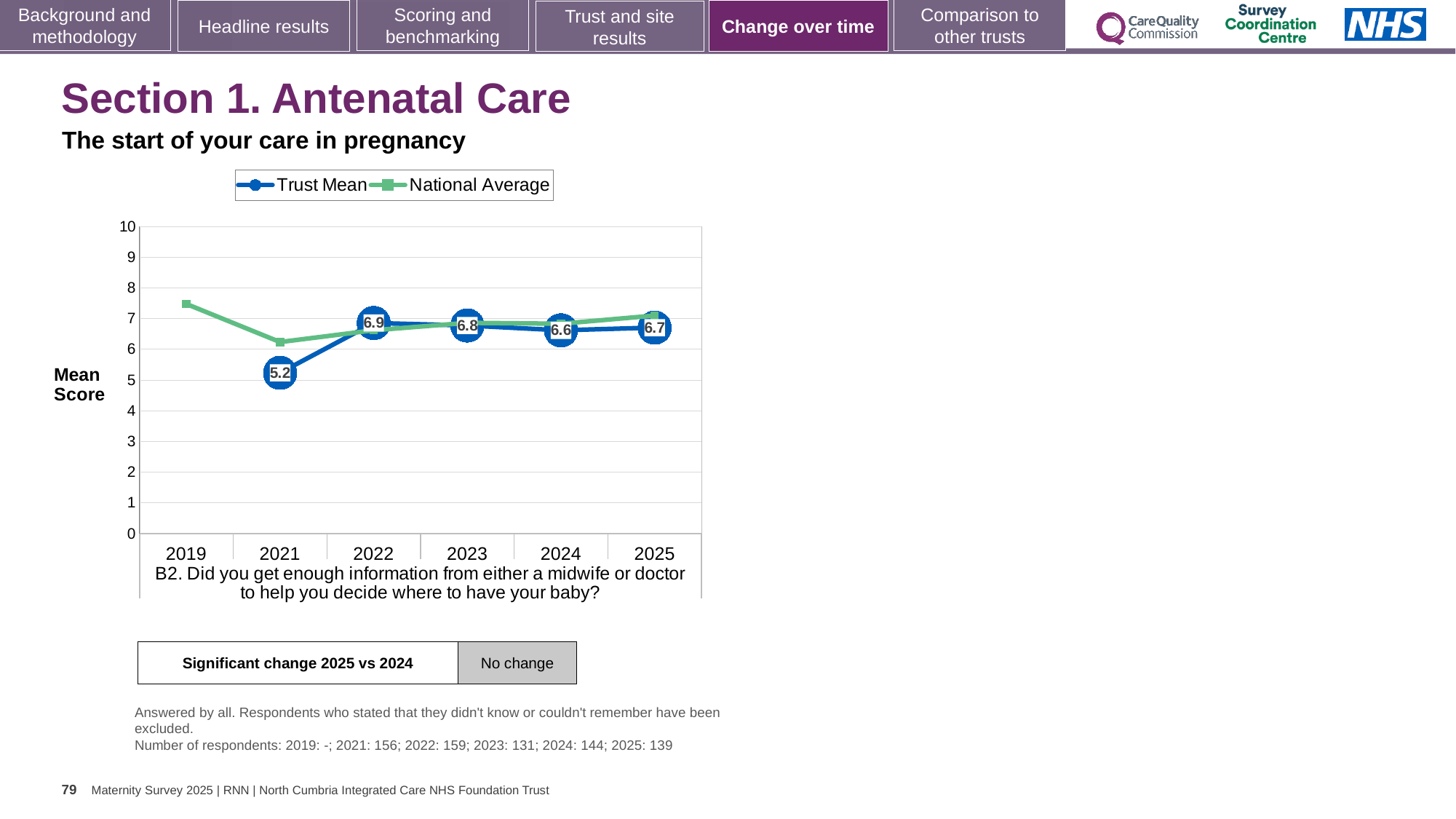
Is the National Average value for 2019 greater or less than 7? greater How many years are shown on the x axis of the chart? 6 In which year is the Trust Mean lowest? 2021 What is the Trust Mean value for 2025? 6.7 In which year is the Trust Mean highest? 2022 What kind of chart is shown on the slide? Line chart What is the Trust Mean value for 2021? 5.2 Which year has the larger Trust Mean, 2023 or 2024? 2023 Is the National Average value for 2021 greater or less than 7? less What is the difference between the Trust Mean in 2022 and in 2021? 1.7 How many series does the legend list? 2 Does the Trust Mean rise or fall from 2021 to 2022? Rise